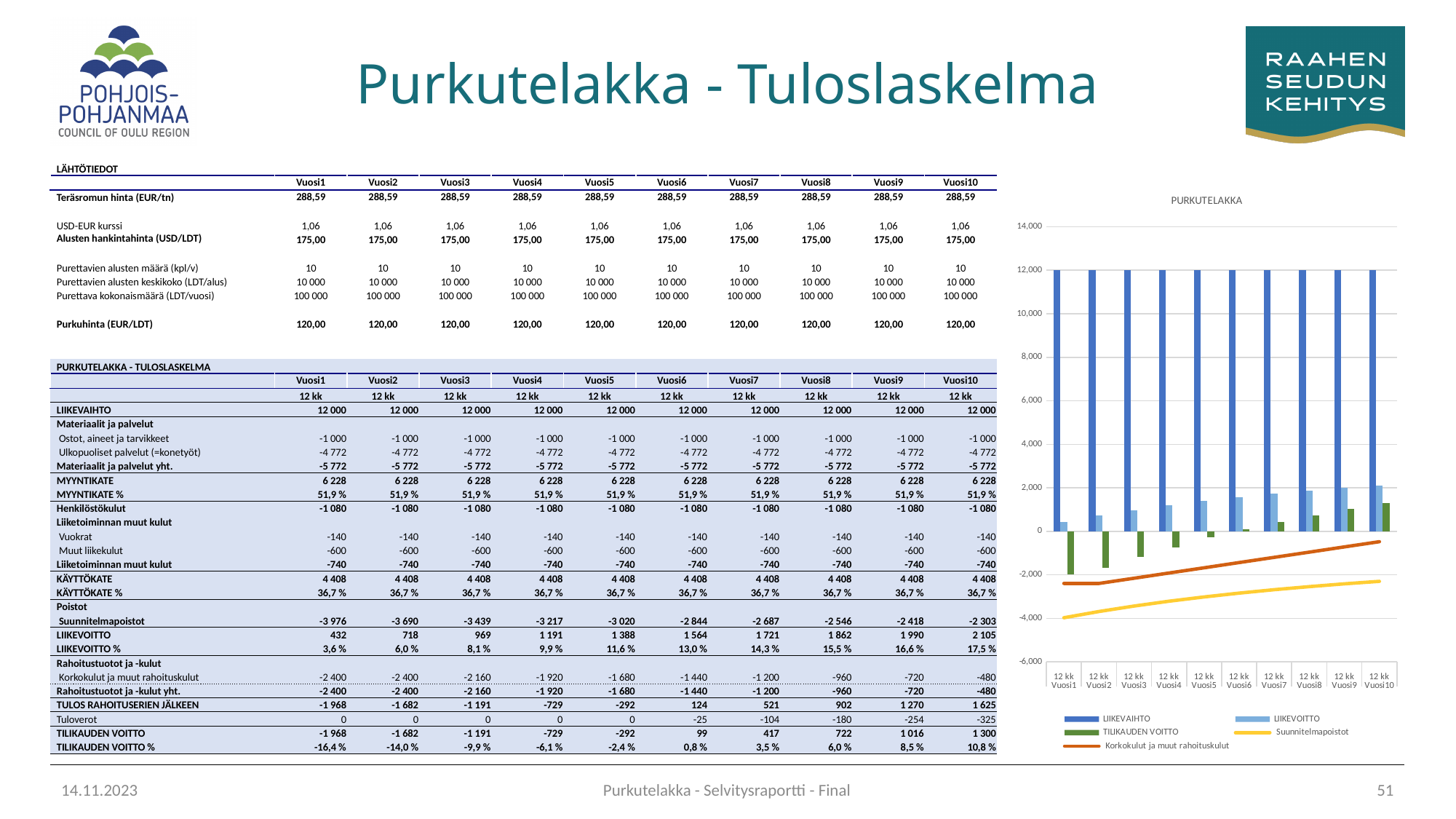
How many years (categories) are shown on the x axis of the chart? 10 Does the Suunnitelmapoistot line rise or fall from Vuosi1 to Vuosi10? rise In which year is LIIKEVOITTO highest? Vuosi10 How many series does the chart legend list? 5 Do the LIIKEVOITTO bars rise or fall from Vuosi1 to Vuosi10? rise What is the value of LIIKEVAIHTO for Vuosi1 in the chart? 12,000 In Vuosi5, which is larger: LIIKEVAIHTO or LIIKEVOITTO? LIIKEVAIHTO What is the title of the chart? PURKUTELAKKA Is the value for Korkokulut ja muut rahoituskulut in Vuosi10 greater or less than -2,000? greater Is the value for TILIKAUDEN VOITTO in Vuosi1 greater or less than 0? less Is the value for Suunnitelmapoistot in Vuosi1 greater or less than -2,000? less What kind of chart is shown on the slide? combined bar and line chart